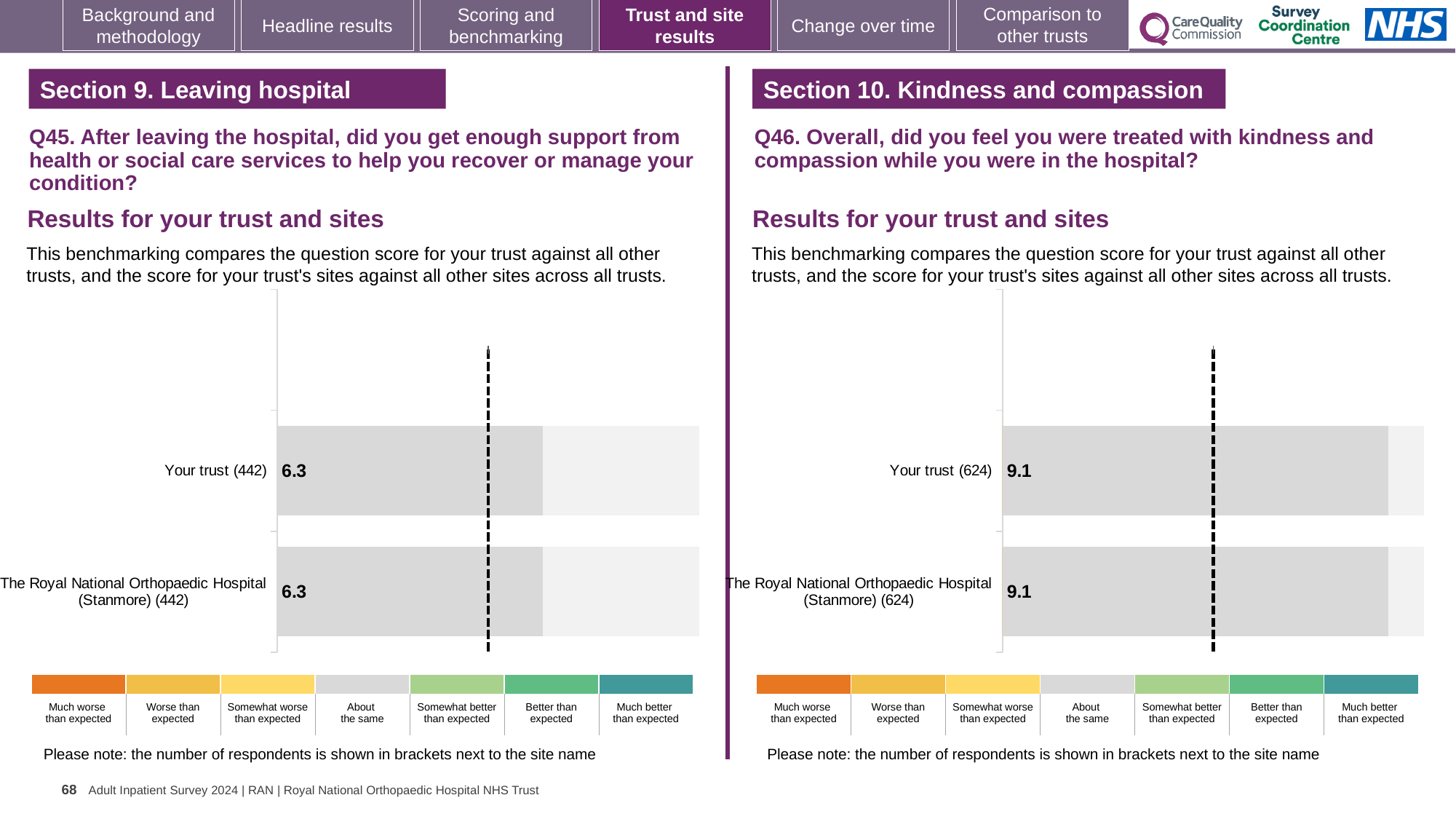
On the Q45 chart (left), what is the difference between the score for Your trust and the score for The Royal National Orthopaedic Hospital (Stanmore)? 0 On the Q46 chart (right), how many respondents are shown in brackets for The Royal National Orthopaedic Hospital (Stanmore)? 624 On the Q46 chart (right), what is the difference between the score for Your trust and the score for The Royal National Orthopaedic Hospital (Stanmore)? 0 On the Q45 chart (left), how many respondents are shown in brackets for Your trust? 442 How many categories does the colour key below the Q45 chart (left) list? 7 How many bars are plotted on the Q46 chart (right)? 2 How many bars are plotted on the Q45 chart (left)? 2 On the Q46 chart (right), what is the score for Your trust? 9.1 On the Q45 chart (left), what is the score for Your trust? 6.3 On the Q46 chart (right), what is the score for The Royal National Orthopaedic Hospital (Stanmore)? 9.1 What kind of chart is the Q46 chart (right)? Bar chart On the Q45 chart (left), what is the score for The Royal National Orthopaedic Hospital (Stanmore)? 6.3